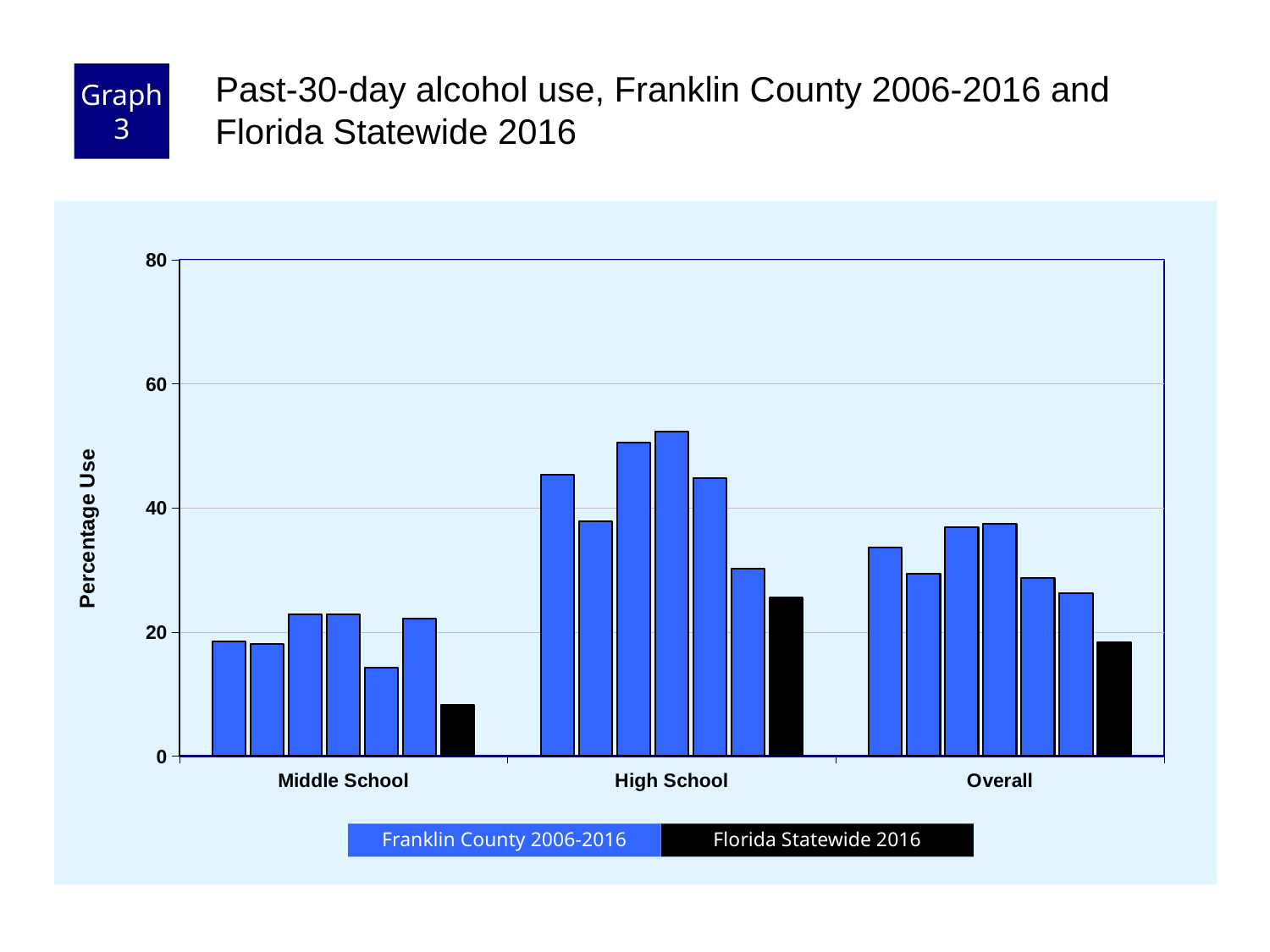
Is the Florida Statewide 2016 value for Middle School greater or less than 20? less How many series does the legend list? 2 Is the Florida Statewide 2016 value for High School greater or less than 20? greater Is the tallest Franklin County 2006-2016 bar for High School greater or less than 40? greater What is the label on the y axis? Percentage Use What colour are the Florida Statewide 2016 bars? black How many category groups are shown along the x axis? 3 Which is larger, the Florida Statewide 2016 value for High School or for Middle School? High School What kind of chart is shown on the slide? bar chart Which category group contains the tallest bar? High School Which category group has the lowest Florida Statewide 2016 bar? Middle School